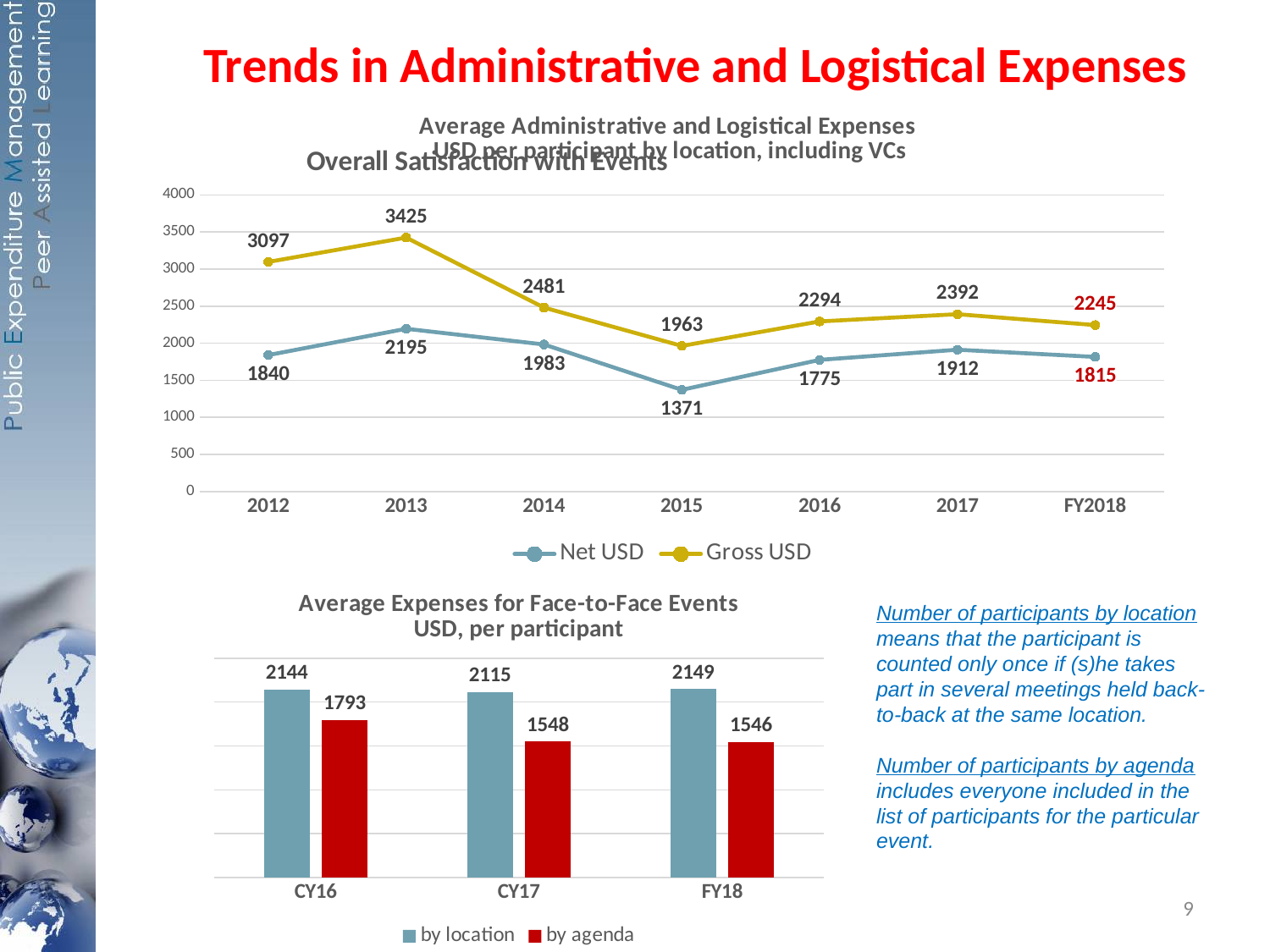
In the bottom chart (Average Expenses for Face-to-Face Events), what is the 'by agenda' value for CY17? 1548 In the top chart (Average Administrative and Logistical Expenses), what is the Net USD value for 2015? 1371 In the top chart (Average Administrative and Logistical Expenses), which year has the highest Gross USD value? 2013 In the top chart (Average Administrative and Logistical Expenses), how many time periods are shown on the x axis? 7 In the bottom chart (Average Expenses for Face-to-Face Events), what is the difference between 'by location' and 'by agenda' for CY16? 351 In the top chart (Average Administrative and Logistical Expenses), which year has the lowest Net USD value? 2015 In the top chart (Average Administrative and Logistical Expenses), what is the Gross USD value for 2013? 3425 In the top chart (Average Administrative and Logistical Expenses), how many series does the legend list? 2 What kind of chart is the top chart (Average Administrative and Logistical Expenses)? Line chart In the bottom chart (Average Expenses for Face-to-Face Events), which period has the highest 'by location' value? FY18 What kind of chart is the bottom chart (Average Expenses for Face-to-Face Events)? Bar chart In the top chart (Average Administrative and Logistical Expenses), what is the difference between Gross USD and Net USD in FY2018? 430